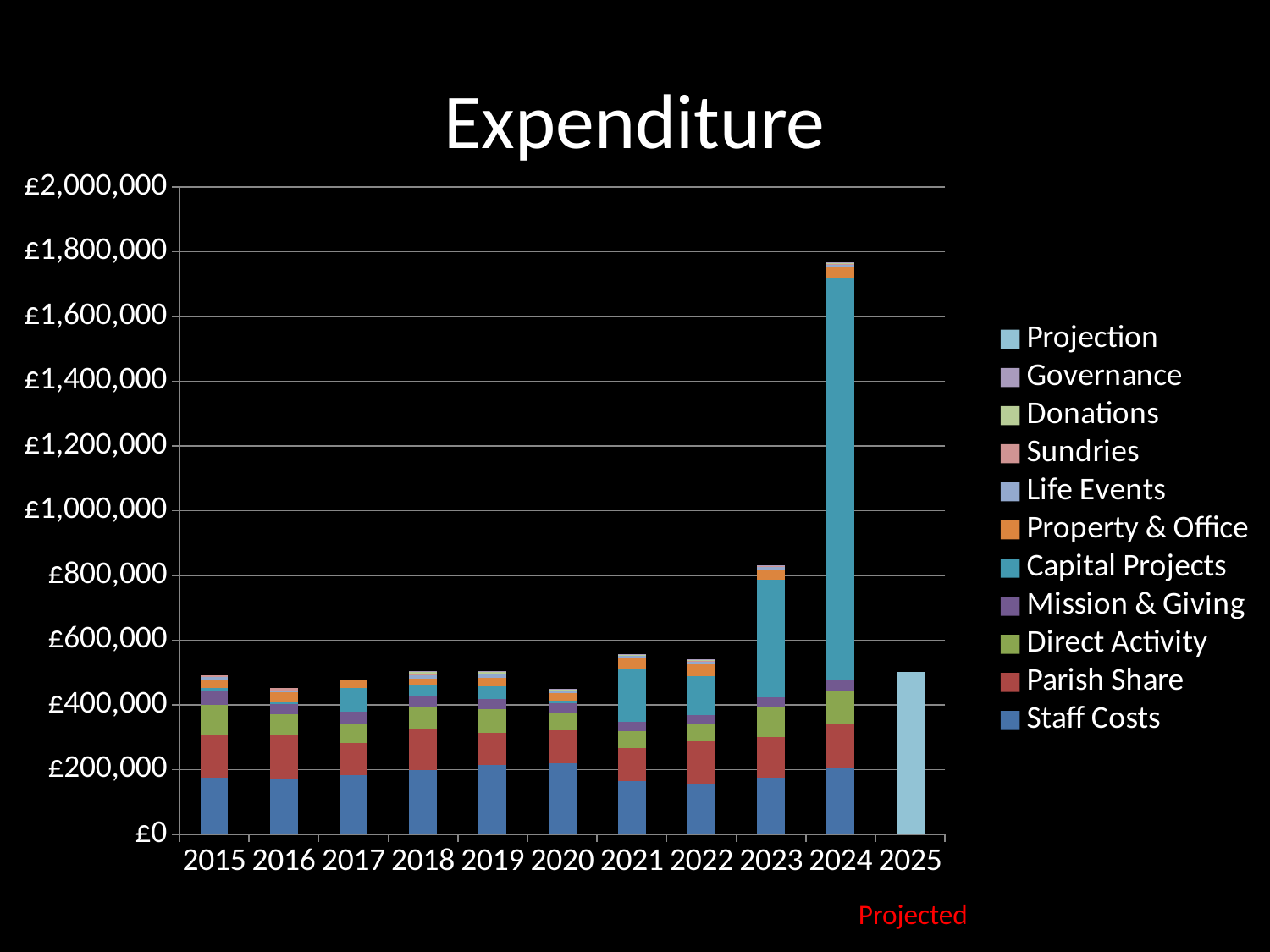
Which year has the larger total expenditure, 2020 or 2021? 2021 Is the value for 2025 greater or less than £400,000? greater Which year has the larger total expenditure, 2023 or 2024? 2024 Is the total expenditure for 2016 greater or less than £600,000? less Which year is marked as projected on the slide? 2025 Is the total expenditure for 2023 greater or less than £1,000,000? less Which year has the highest total expenditure? 2024 What kind of chart is shown on the slide? Stacked bar chart How many series does the legend list? 11 How many years are shown along the x axis of the chart? 11 What is the title of the chart? Expenditure